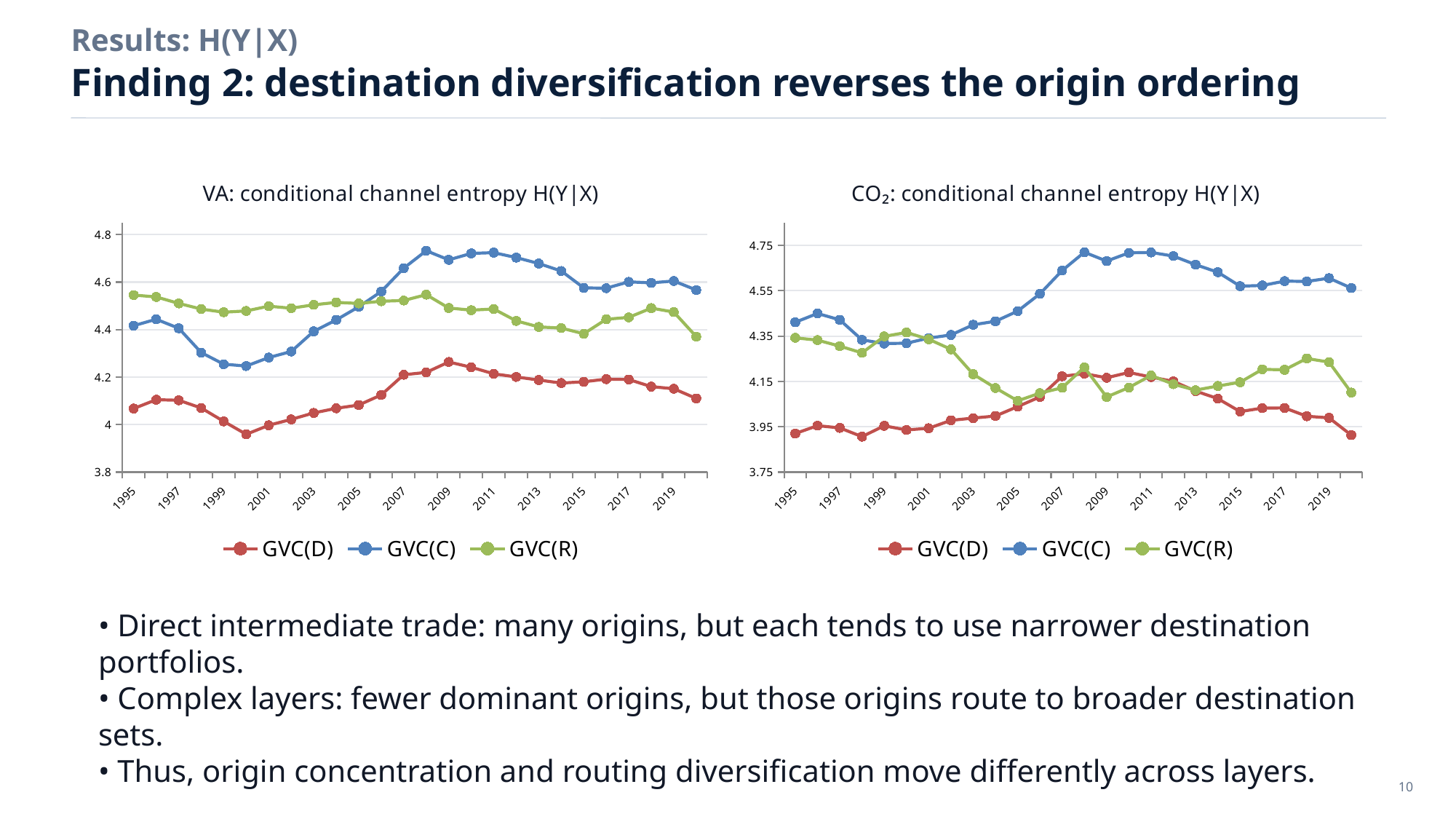
In the right chart (CO2), which colour is used for the GVC(R) series? green In the left chart (VA), which series has the lowest value in 1995? GVC(D) In the right chart (CO2), is the value of GVC(D) in 1995 greater or less than 3.95? less What kind of chart is the left chart titled "VA: conditional channel entropy H(Y|X)"? line chart How many year labels are shown on the x axis of the left chart (VA)? 13 In the right chart (CO2), which is larger in 2011: GVC(C) or GVC(R)? GVC(C) In the left chart (VA), is the value of GVC(D) in 2000 greater or less than 4? less In the left chart (VA), does GVC(D) rise or fall between 2000 and 2009? rise In the right chart (CO2), is the value of GVC(C) in 2008 greater or less than 4.55? greater In the left chart (VA), which series has the highest value in 2020? GVC(C) How many series does the legend of the right chart (CO2: conditional channel entropy H(Y|X)) list? 3